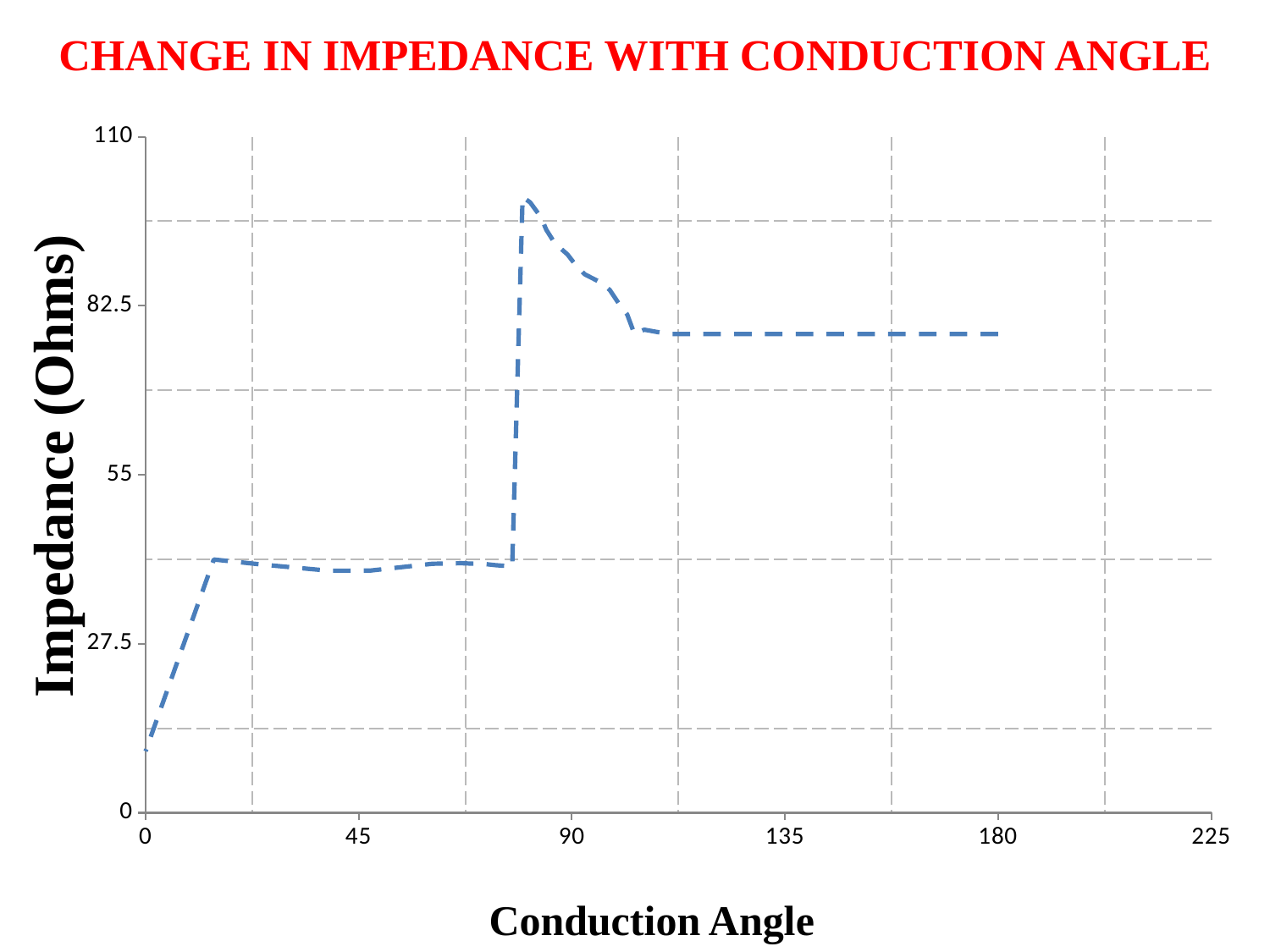
What is the label of the vertical axis? Impedance (Ohms) Is the impedance at a conduction angle of 135 larger or smaller than the impedance at a conduction angle of 45? larger Does the impedance rise or fall as the conduction angle increases from 0 to about 15? rise Is the impedance at a conduction angle of 0 greater or less than 27.5? less Is the impedance at a conduction angle of 45 greater or less than 27.5? greater Is the impedance at a conduction angle of 180 greater or less than 55? greater What is the title of the chart? CHANGE IN IMPEDANCE WITH CONDUCTION ANGLE Does the impedance rise or fall as the conduction angle increases from 90 to 100? fall What kind of chart is shown on the slide? line chart